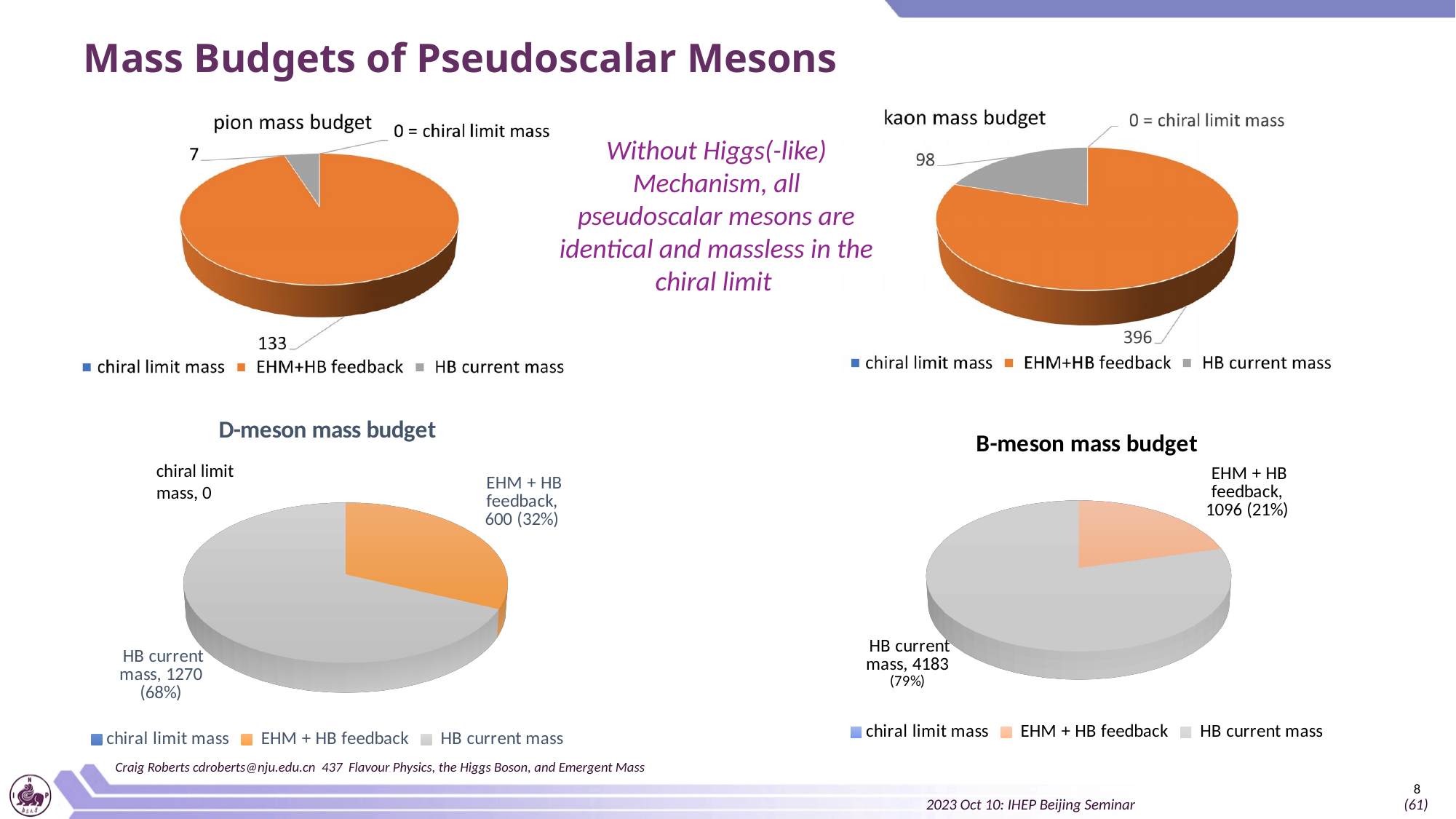
In the pion mass budget chart, what is the value for EHM+HB feedback? 133 In the D-meson mass budget chart, what is the value for HB current mass? 1270 In the D-meson mass budget chart, what share of the pie is HB current mass? 68% What kind of chart is the B-meson mass budget chart? pie chart In the kaon mass budget chart, what is the value for HB current mass? 98 In the pion mass budget chart, which category has the largest value? EHM+HB feedback In the pion mass budget chart, what is the value for HB current mass? 7 How many series does the legend of the D-meson mass budget chart list? 3 In the kaon mass budget chart, what is the value for EHM+HB feedback? 396 In the B-meson mass budget chart, what share of the pie is EHM + HB feedback? 21% In the kaon mass budget chart, what is the difference between EHM+HB feedback and HB current mass? 298 In the B-meson mass budget chart, which is larger, HB current mass or EHM + HB feedback? HB current mass